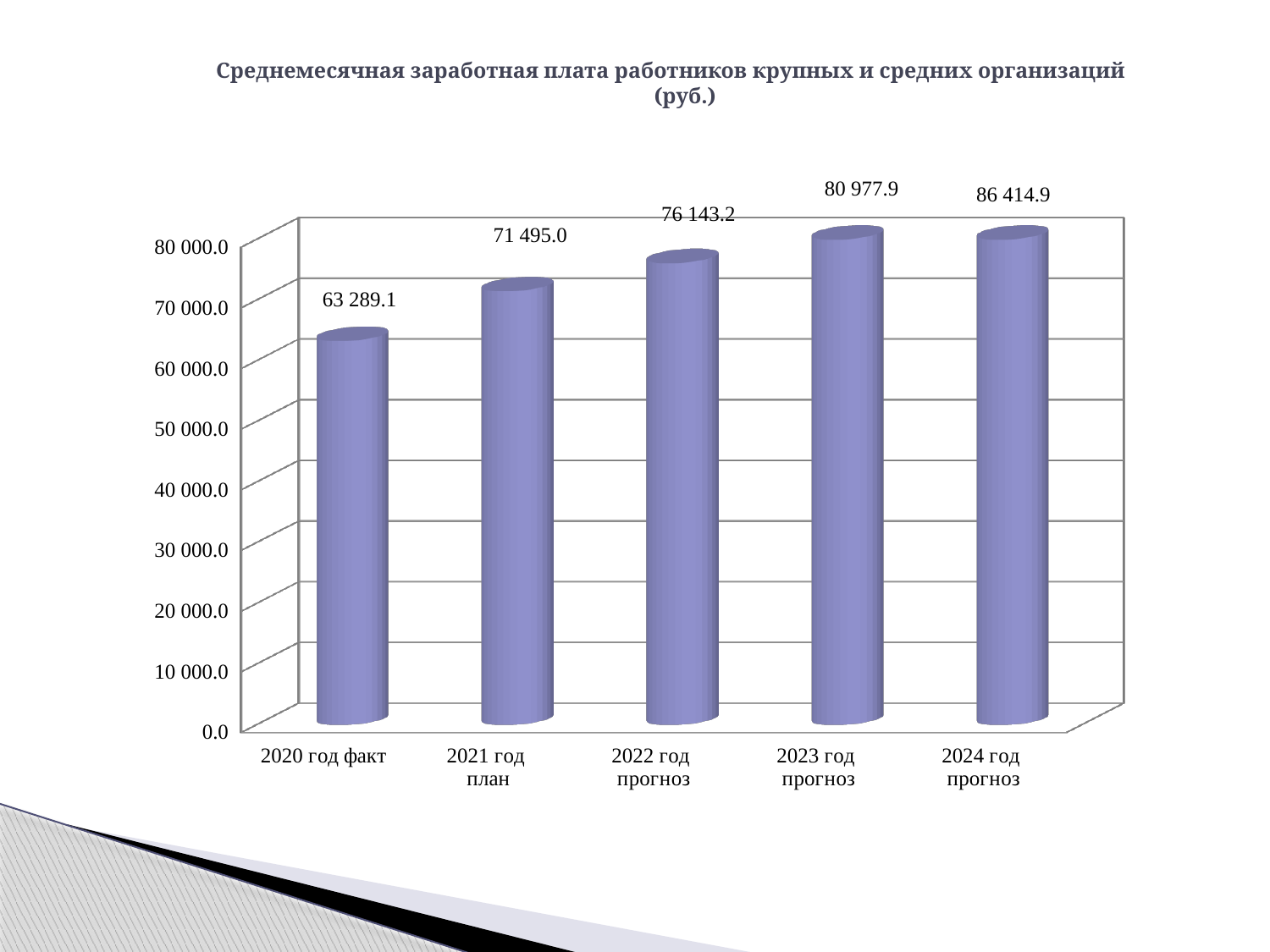
What is the value for 2020 год факт? 63 289.1 Which is larger, the value for 2023 год прогноз or the value for 2022 год прогноз? 2023 год прогноз What kind of chart is shown on the slide? bar chart Which category has the lowest value? 2020 год факт What is the difference between the values for 2021 год план and 2020 год факт? 8 205.9 Which category has the highest value? 2024 год прогноз Do the values rise or fall from 2020 год факт to 2024 год прогноз? rise How many categories are shown on the x axis? 5 Is the value for 2021 год план greater or less than 70 000.0? greater What is the difference between the values for 2024 год прогноз and 2020 год факт? 23 125.8 What is the value for 2022 год прогноз? 76 143.2 What is the value for 2024 год прогноз? 86 414.9